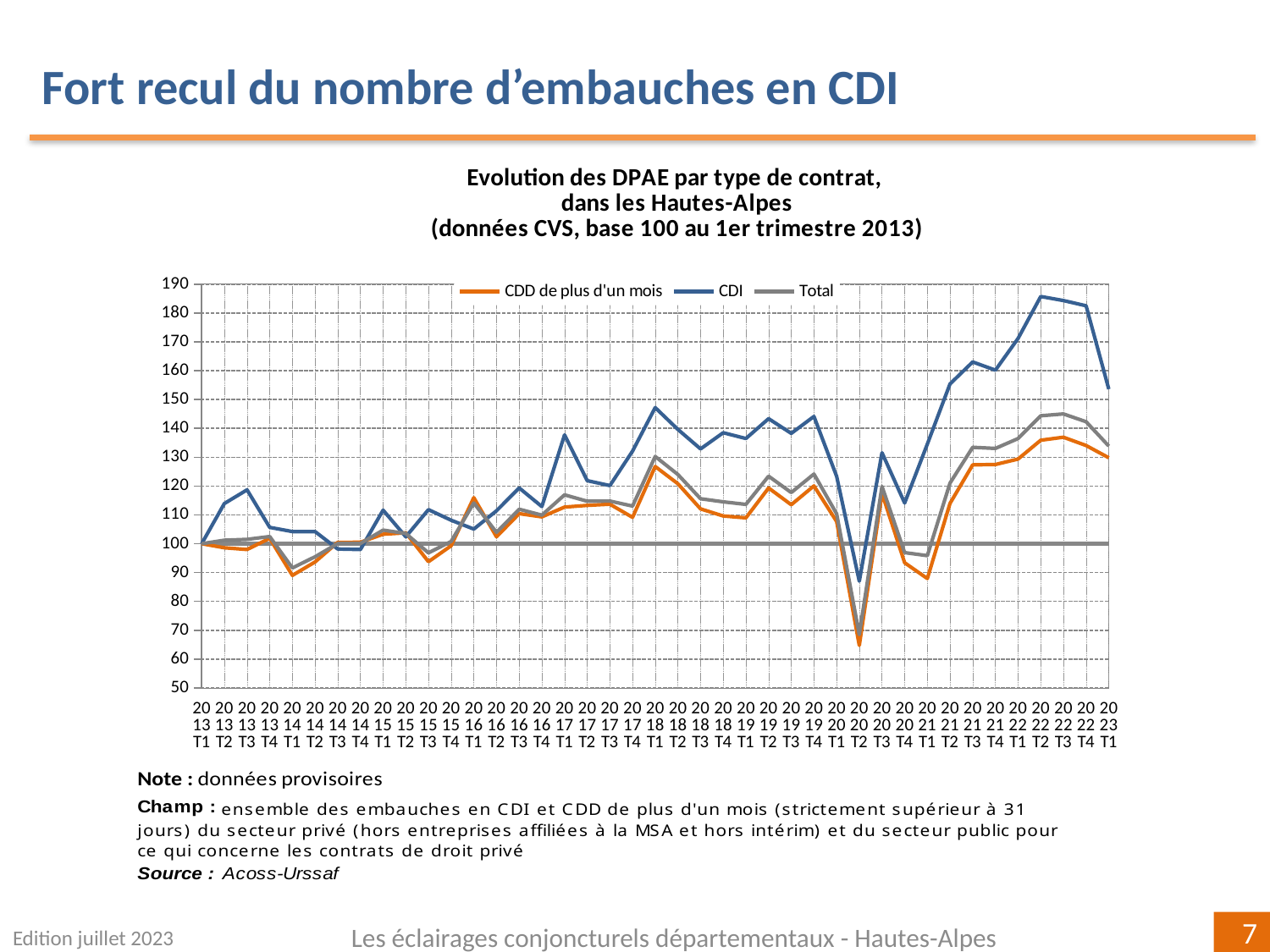
What is the title of the chart? Evolution des DPAE par type de contrat, dans les Hautes-Alpes (données CVS, base 100 au 1er trimestre 2013) What is the index value of the series at 2013 T1, the base quarter? 100 Is the value of the CDI series at 2023 T1 greater or less than 150? greater How many quarterly points are plotted along the x axis, from 2013 T1 to 2023 T1? 41 At 2023 T1, which series has the higher value: CDI or CDD de plus d'un mois? CDI In which quarter does the CDD de plus d'un mois series reach its lowest value? 2020 T2 Is the value of the CDD de plus d'un mois series at 2020 T2 greater or less than 70? less Is the value of the CDI series at 2022 T2 greater or less than 180? greater Does the CDI series rise or fall between 2022 T4 and 2023 T1? fall How many series does the legend list? 3 Which series reaches the highest value on the chart? CDI What kind of chart is shown on the slide? line chart